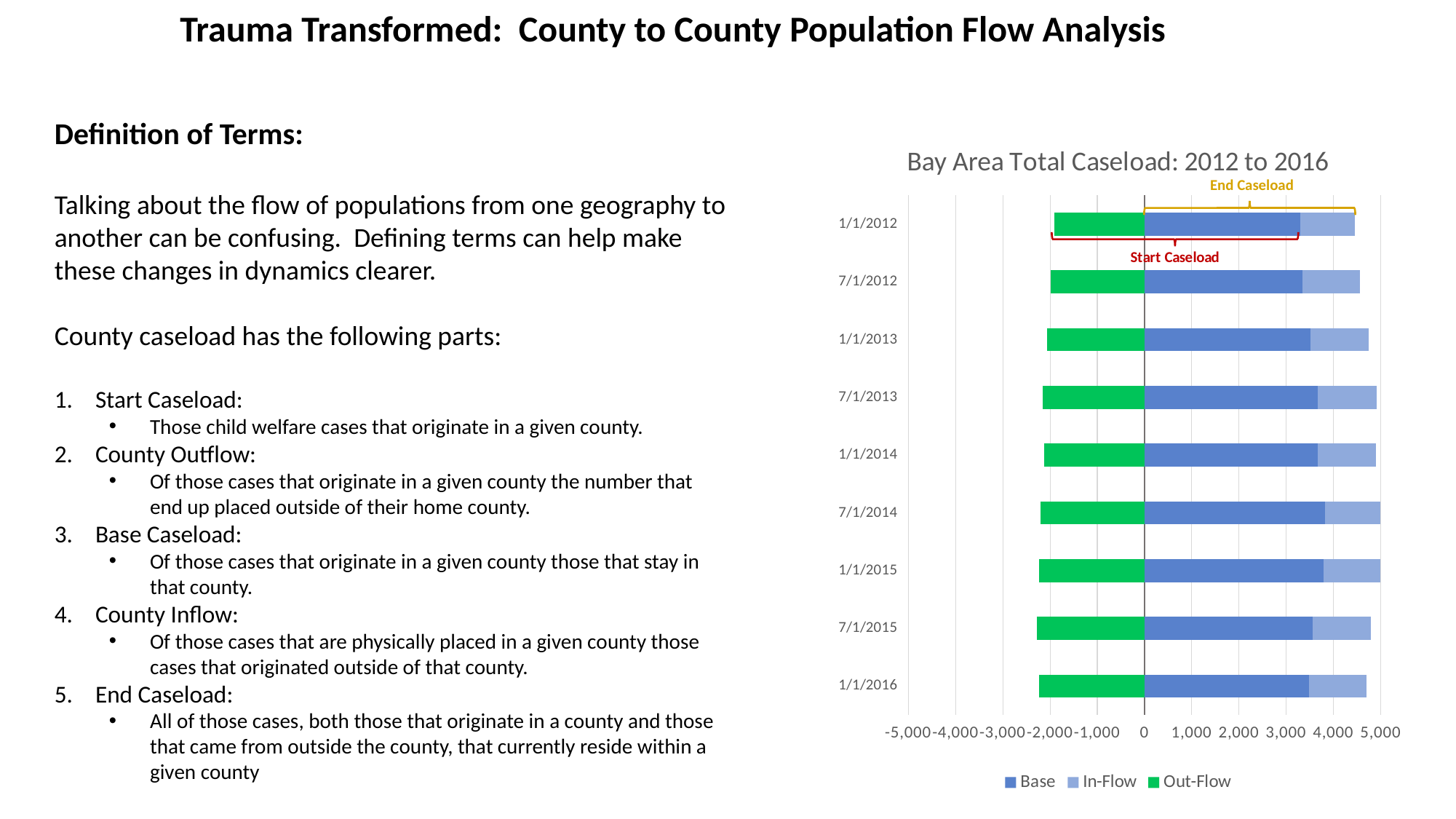
How many dates (categories) are plotted on the chart? 9 Is the Base value for 7/1/2014 greater or less than 3,000? greater Is the Base value for 1/1/2016 greater or less than 4,000? less Is the In-Flow value for 1/1/2012 greater or less than 2,000? less Which series is plotted on the negative side of the axis? Out-Flow Which series in the chart is shown in green? Out-Flow What is the title of the chart on the slide? Bay Area Total Caseload: 2012 to 2016 Is the Base value for 1/1/2012 larger or smaller than the Base value for 7/1/2014? smaller How many series does the chart legend list? 3 What kind of chart is shown on the slide? bar chart